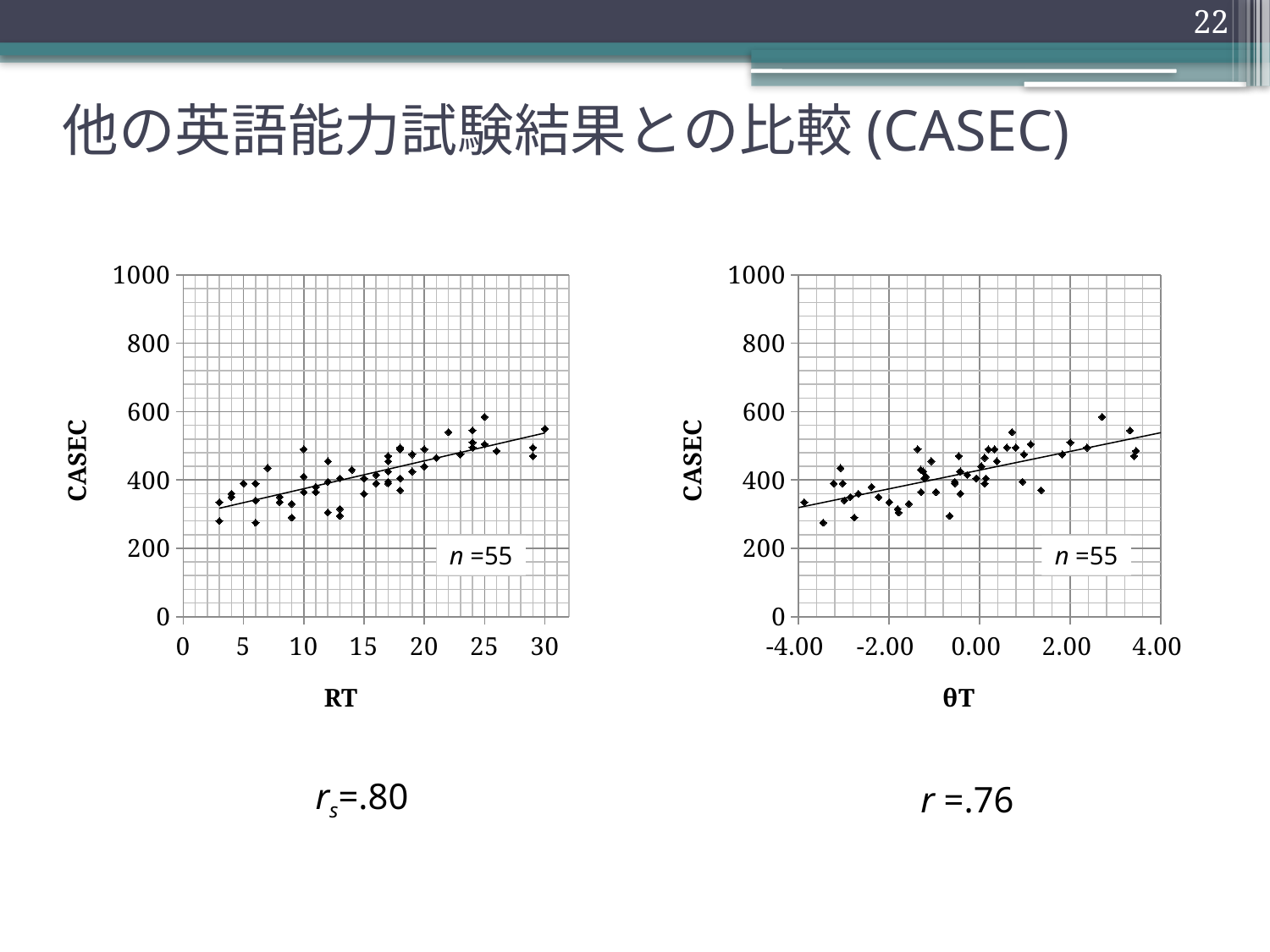
What is the label of the x axis on the left chart? RT In the right chart, is the lowest CASEC value plotted greater or less than 200? greater What is the label of the x axis on the right chart? θT What kind of chart is the left chart (CASEC vs RT)? scatter plot In the left chart, do CASEC values generally rise or fall as RT increases? rise In the left chart, how many data points are there according to the n label? 55 What kind of chart is the right chart (CASEC vs θT)? scatter plot In the left chart, is the highest CASEC value plotted greater or less than 800? less In the left chart, what is the highest value shown on the y axis? 1000 In the right chart, how many data points are there according to the n label? 55 In the right chart, do CASEC values generally rise or fall as θT increases? rise